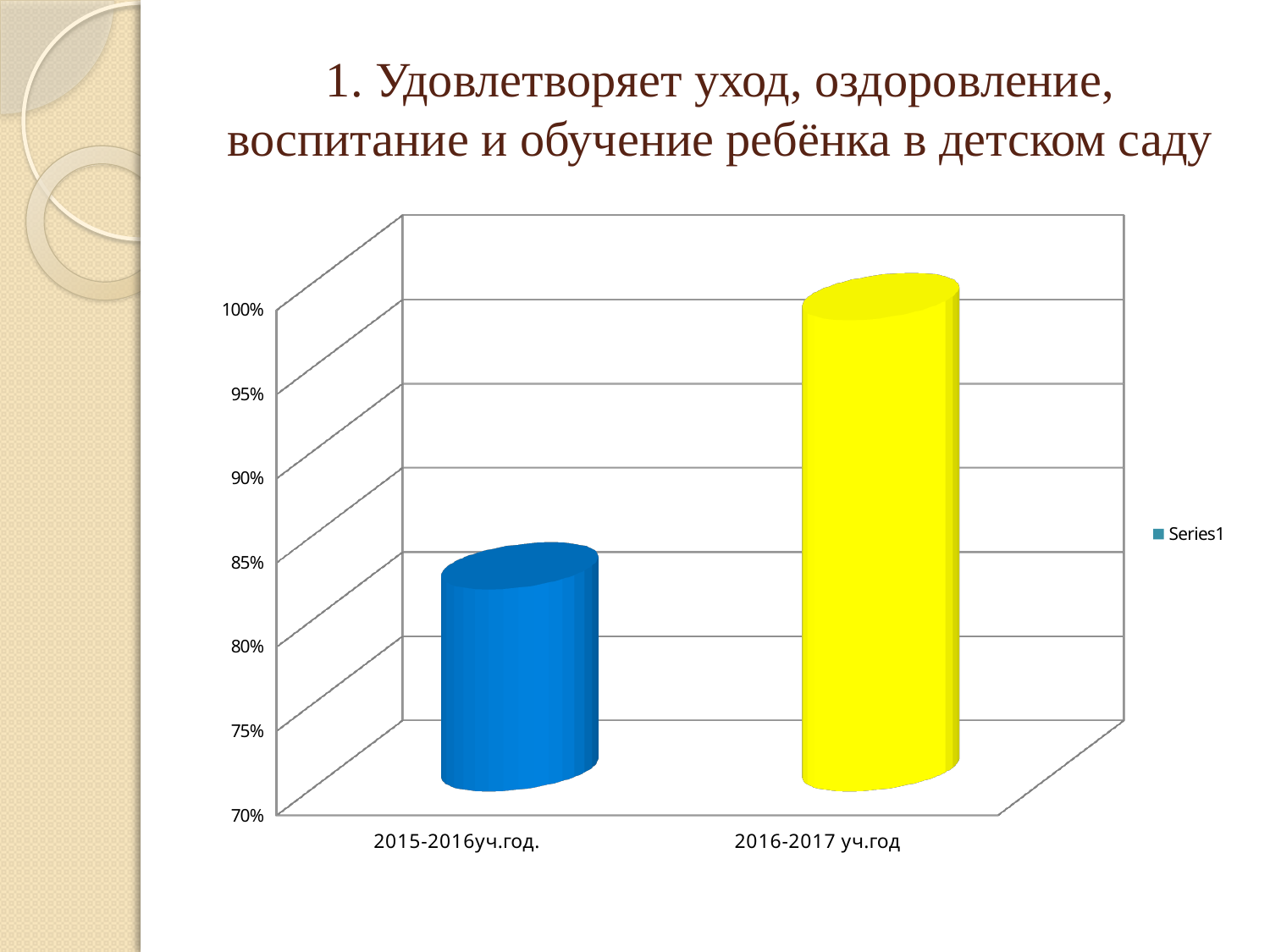
What kind of chart is shown on the slide? bar chart What colour is the bar for 2016-2017 уч.год? yellow How many series does the chart legend list? 1 Which category has the lowest value in the chart? 2015-2016уч.год. What is the name of the series listed in the chart legend? Series1 Which category has the highest value in the chart? 2016-2017 уч.год Which is larger, the value for 2015-2016уч.год. or the value for 2016-2017 уч.год? 2016-2017 уч.год Is the value for 2016-2017 уч.год greater or less than 95%? greater Is the value for 2015-2016уч.год. greater or less than 90%? less Do the values rise or fall from 2015-2016уч.год. to 2016-2017 уч.год? rise Is the value for 2015-2016уч.год. greater or less than 80%? greater How many categories are shown on the x axis of the chart? 2